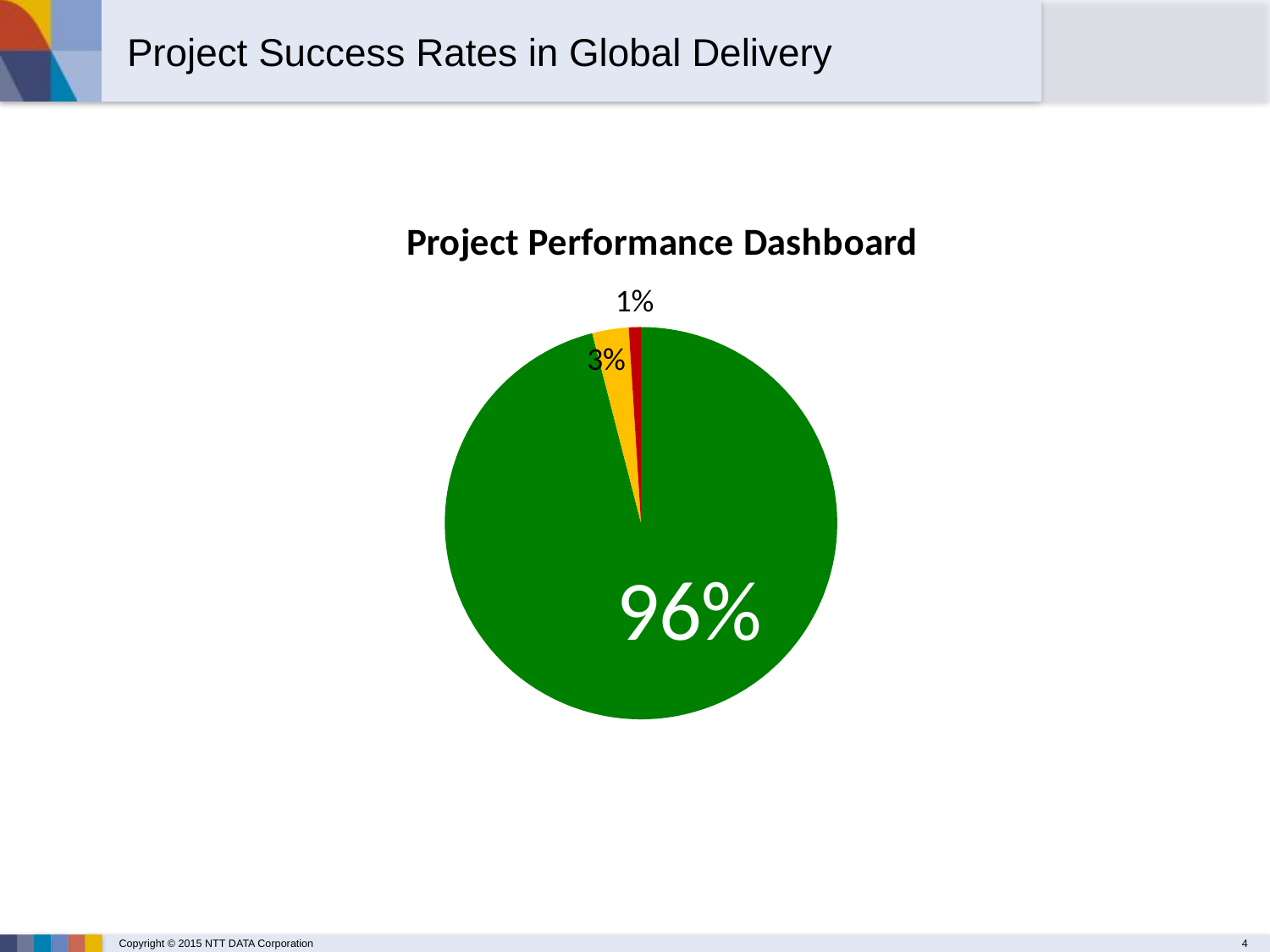
What percentage does the largest slice of the pie represent? 96% What colour is the largest slice of the pie? green What percentage is shown on the yellow slice? 3% What is the title of the chart? Project Performance Dashboard How many slices does the pie chart have? 3 Which slice is larger, the yellow slice or the red slice? yellow What percentage is shown on the red slice? 1% What do the three slice percentages add up to? 100% What percentage is shown on the green slice? 96% What is the difference in percentage points between the green slice and the yellow slice? 93 What kind of chart is shown on the slide? pie chart What percentage does the smallest slice of the pie represent? 1%